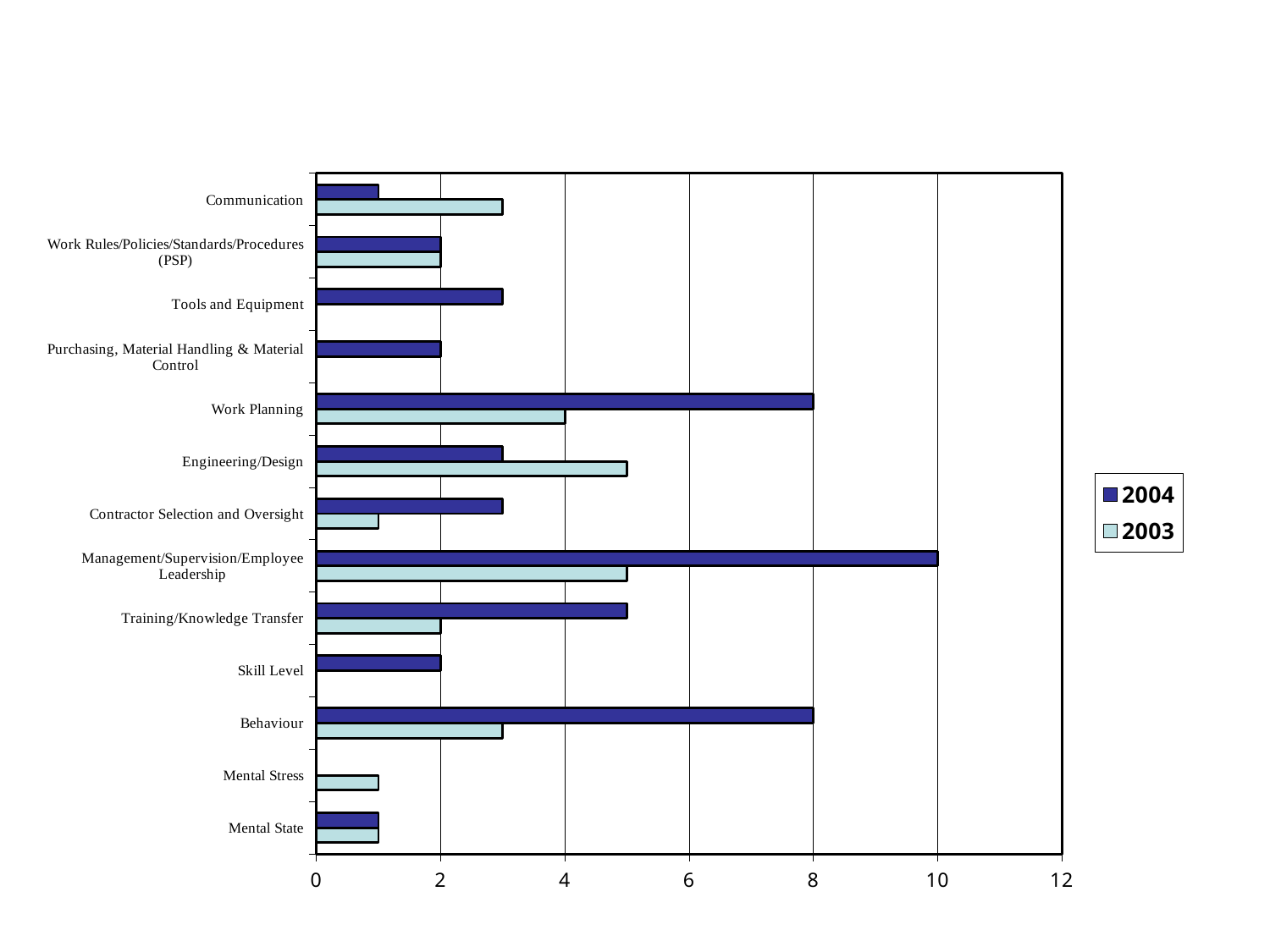
What are the two entries in the legend? 2004 and 2003 What is the 2003 value for Work Planning? 4 Is the 2004 value for Training/Knowledge Transfer greater or less than 4? greater For Engineering/Design, which series has the larger value, 2003 or 2004? 2003 What kind of chart is shown on the slide? bar chart What is the difference between the 2004 and 2003 values for Work Planning? 4 What is the 2004 value for Work Planning? 8 How many categories are plotted on the chart? 13 What is the 2004 value for Behaviour? 8 Which category has the highest 2004 value? Management/Supervision/Employee Leadership How many series does the legend list? 2 What is the 2004 value for Management/Supervision/Employee Leadership? 10